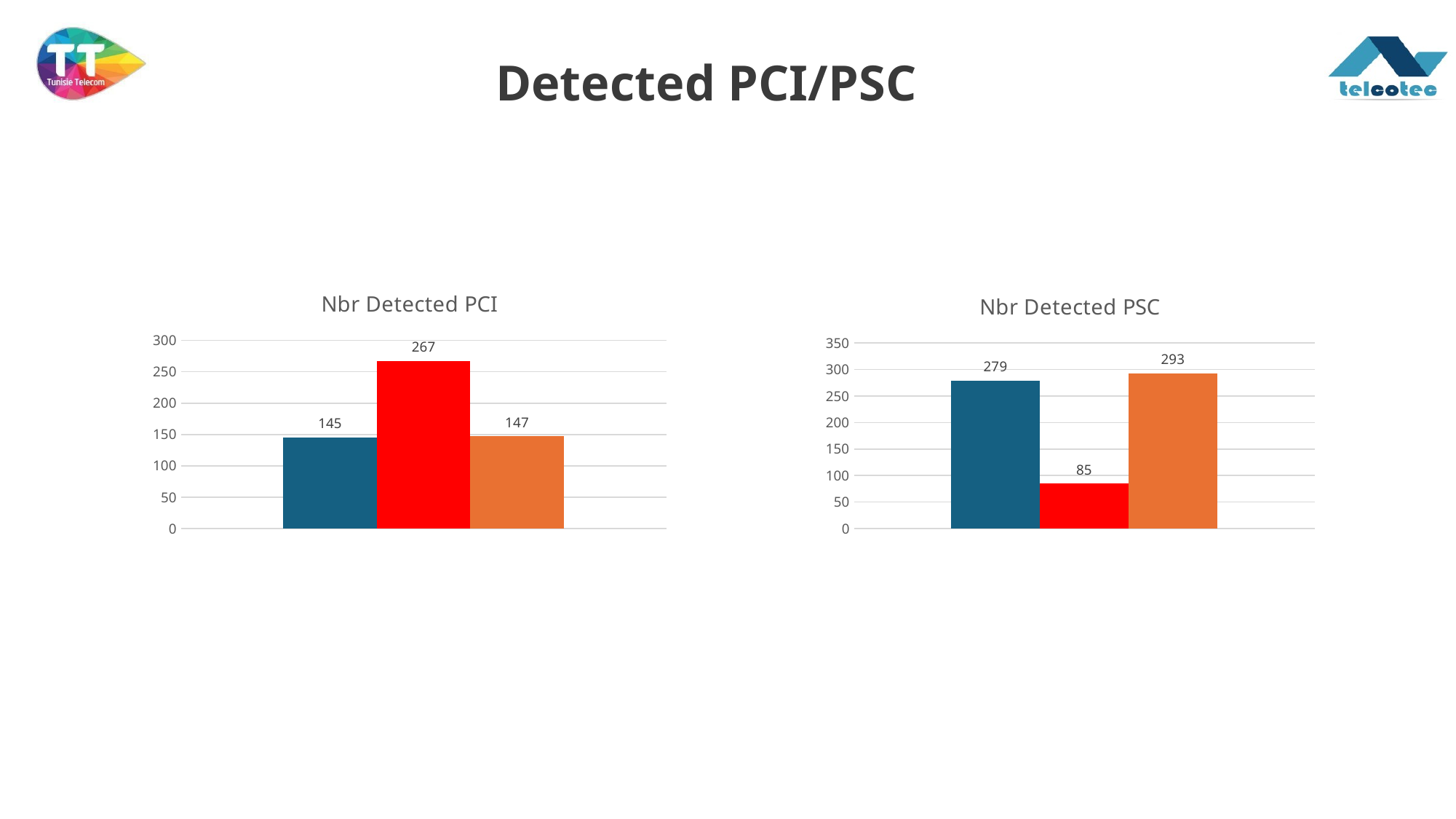
What type of chart is 'Nbr Detected PCI'? Bar chart In the 'Nbr Detected PCI' chart, what is the value of the red bar? 267 In the 'Nbr Detected PCI' chart, which bar has the highest value? The red bar (267) In the 'Nbr Detected PCI' chart, which is larger, the orange bar or the blue bar? The orange bar (147) In the 'Nbr Detected PSC' chart, what is the value of the orange bar? 293 In the 'Nbr Detected PSC' chart, what is the difference between the orange bar and the blue bar? 14 In the 'Nbr Detected PCI' chart, what is the difference between the red bar and the blue bar? 122 In the 'Nbr Detected PSC' chart, which bar has the lowest value? The red bar (85) In the 'Nbr Detected PCI' chart, what is the value of the first (blue) bar? 145 In the 'Nbr Detected PSC' chart, what is the value of the red bar? 85 What is the title of the chart on the right side of the slide? Nbr Detected PSC How many bars are plotted in the 'Nbr Detected PSC' chart? 3